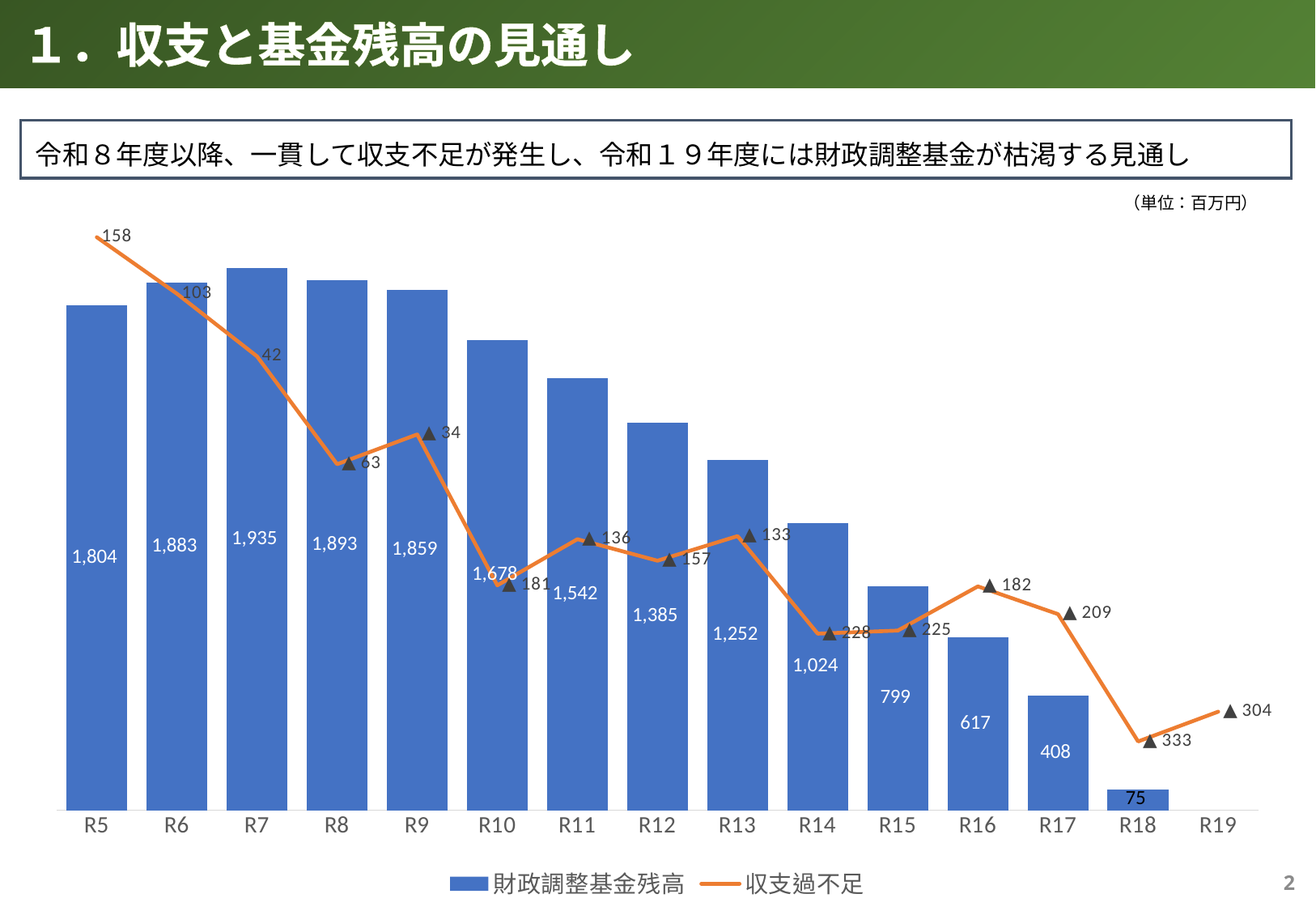
How many series does the legend list? 2 What is the value of 財政調整基金残高 for R14? 1,024 Which year has the lowest labelled 財政調整基金残高 bar? R18 Which is larger, the 財政調整基金残高 for R12 or for R13? R12 What is the value of 財政調整基金残高 for R7? 1,935 Which year has the highest 財政調整基金残高? R7 What kind of chart is this? Combination bar and line chart How many years are shown on the x axis? 15 What is the difference between the 財政調整基金残高 for R5 and R6? 79 What is the value of 収支過不足 for R18? ▲333 Do the 財政調整基金残高 bars rise or fall from R7 to R18? Fall What is the value of 収支過不足 for R5? 158